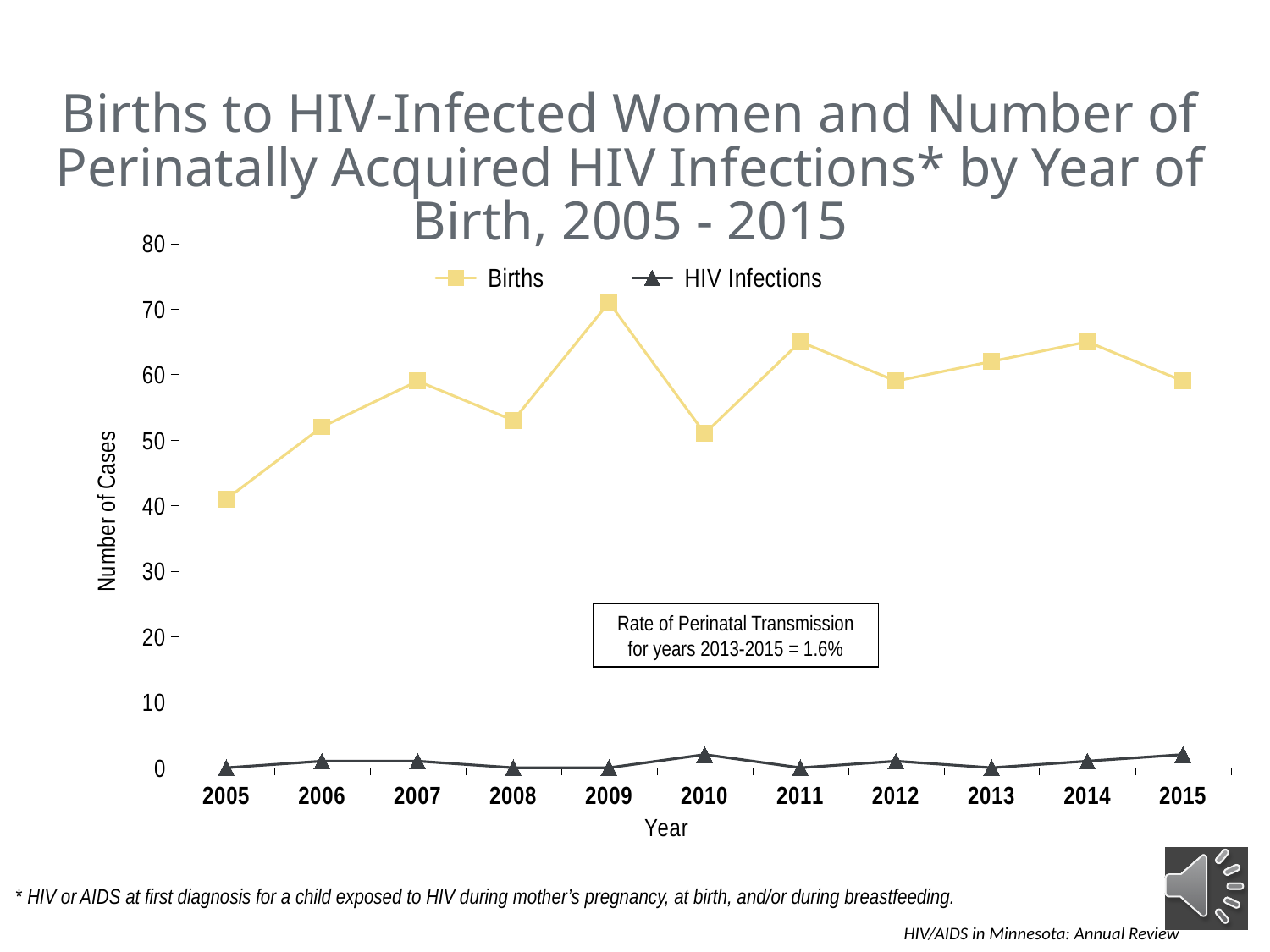
Is the value for Births in 2011 greater or less than 60? greater Do the Births values rise or fall from 2005 to 2007? rise Is the value for HIV Infections in 2010 greater or less than 10? less Is the value for Births in 2005 greater or less than 50? less How many years are plotted along the x axis? 11 Which is larger, Births in 2009 or Births in 2010? Births in 2009 In which year is the Births series highest? 2009 In which year is the Births series lowest? 2005 How many series does the legend list? 2 What rate of perinatal transmission for 2013-2015 is stated in the box on the chart? 1.6% What kind of chart is shown on the slide? line chart